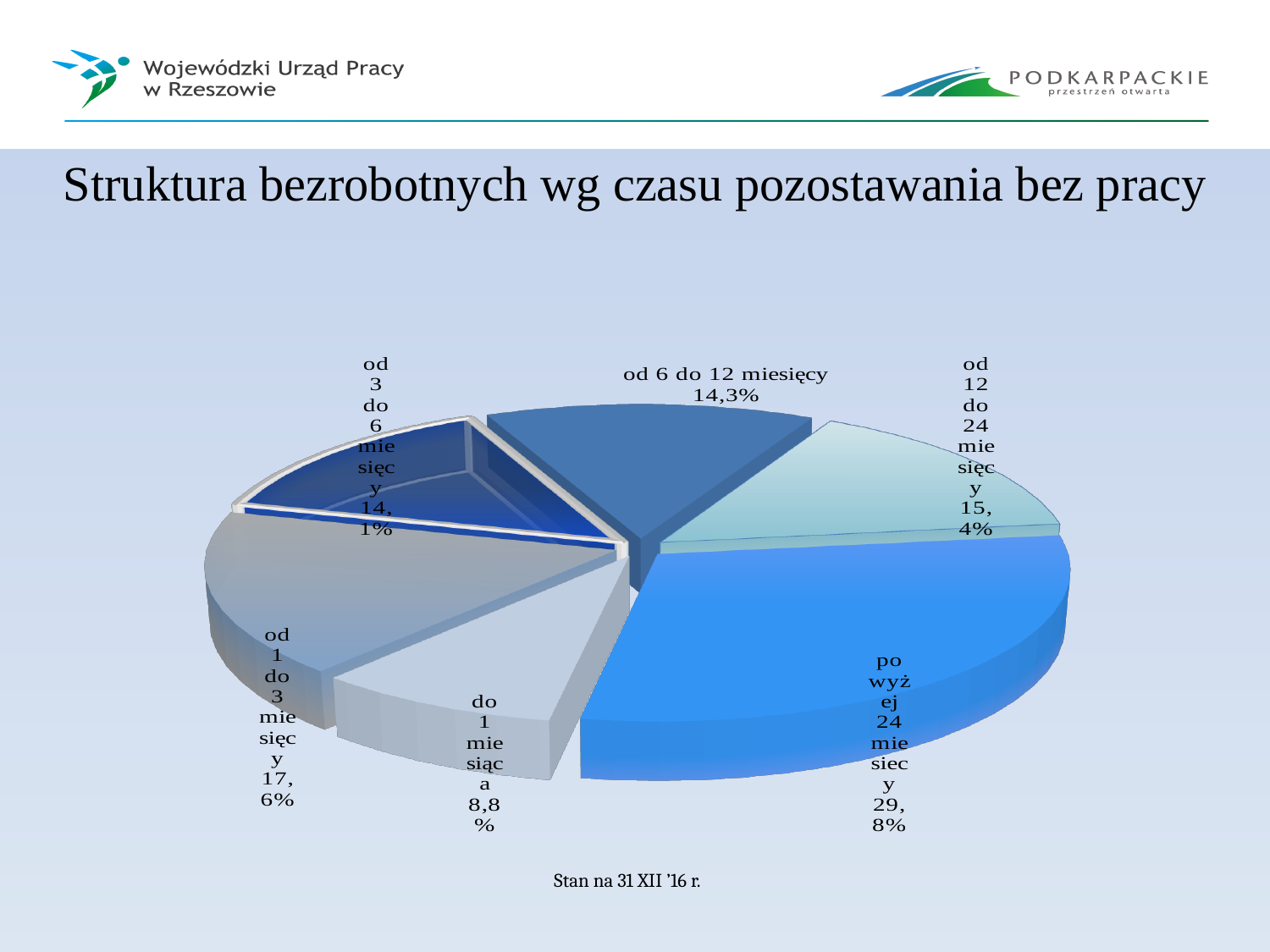
What is the title of the chart on the slide? Struktura bezrobotnych wg czasu pozostawania bez pracy What share of the pie is labelled 'od 6 do 12 miesięcy'? 14,3% Which category has the largest share of the pie? powyżej 24 miesięcy What kind of chart is shown on the slide? pie chart What date does the note below the chart give for the data? 31 XII '16 What share of the pie is labelled 'od 12 do 24 miesięcy'? 15,4% What is the difference in percentage points between 'powyżej 24 miesięcy' and 'od 1 do 3 miesięcy'? 12,2 Which category has the smallest share of the pie? do 1 miesiąca What share of the pie is labelled 'powyżej 24 miesięcy'? 29,8% How many slices does the pie chart have? 6 What share of the pie is labelled 'do 1 miesiąca'? 8,8% Which is larger: the share for 'od 1 do 3 miesięcy' or for 'od 12 do 24 miesięcy'? od 1 do 3 miesięcy